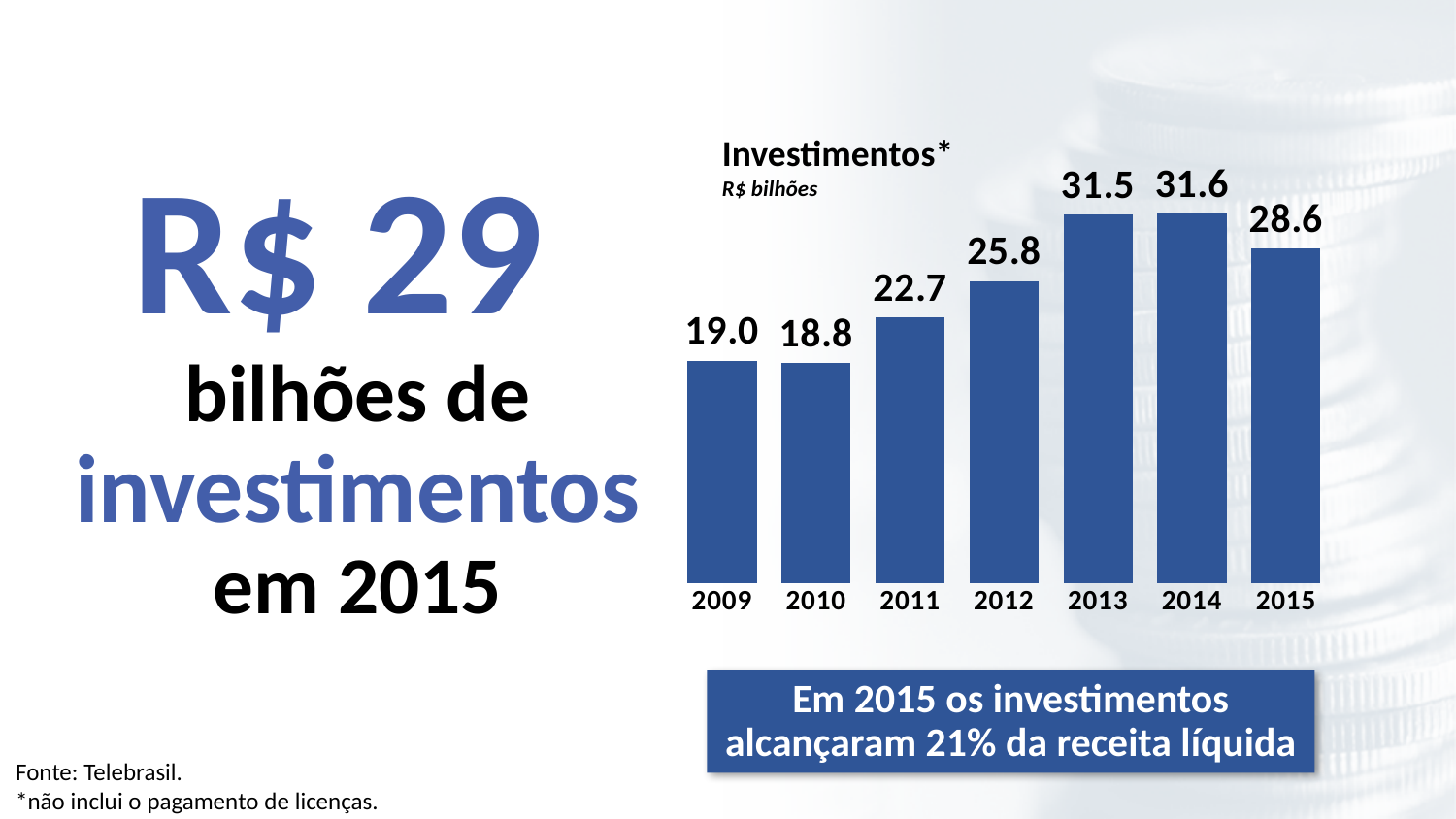
What is the investment value for 2015? 28.6 Do the investment values rise or fall from 2010 to 2014? rise What is the investment value for 2013? 31.5 How many years are shown on the chart? 7 What is the difference between the investment values for 2012 and 2011? 3.1 What unit is given below the chart title? R$ bilhões Which year has the highest investment value? 2014 What is the investment value for 2009? 19.0 Which year has the lowest investment value? 2010 What kind of chart is shown on the slide? bar chart What is the title of the chart? Investimentos* Which year has a larger investment value, 2015 or 2012? 2015